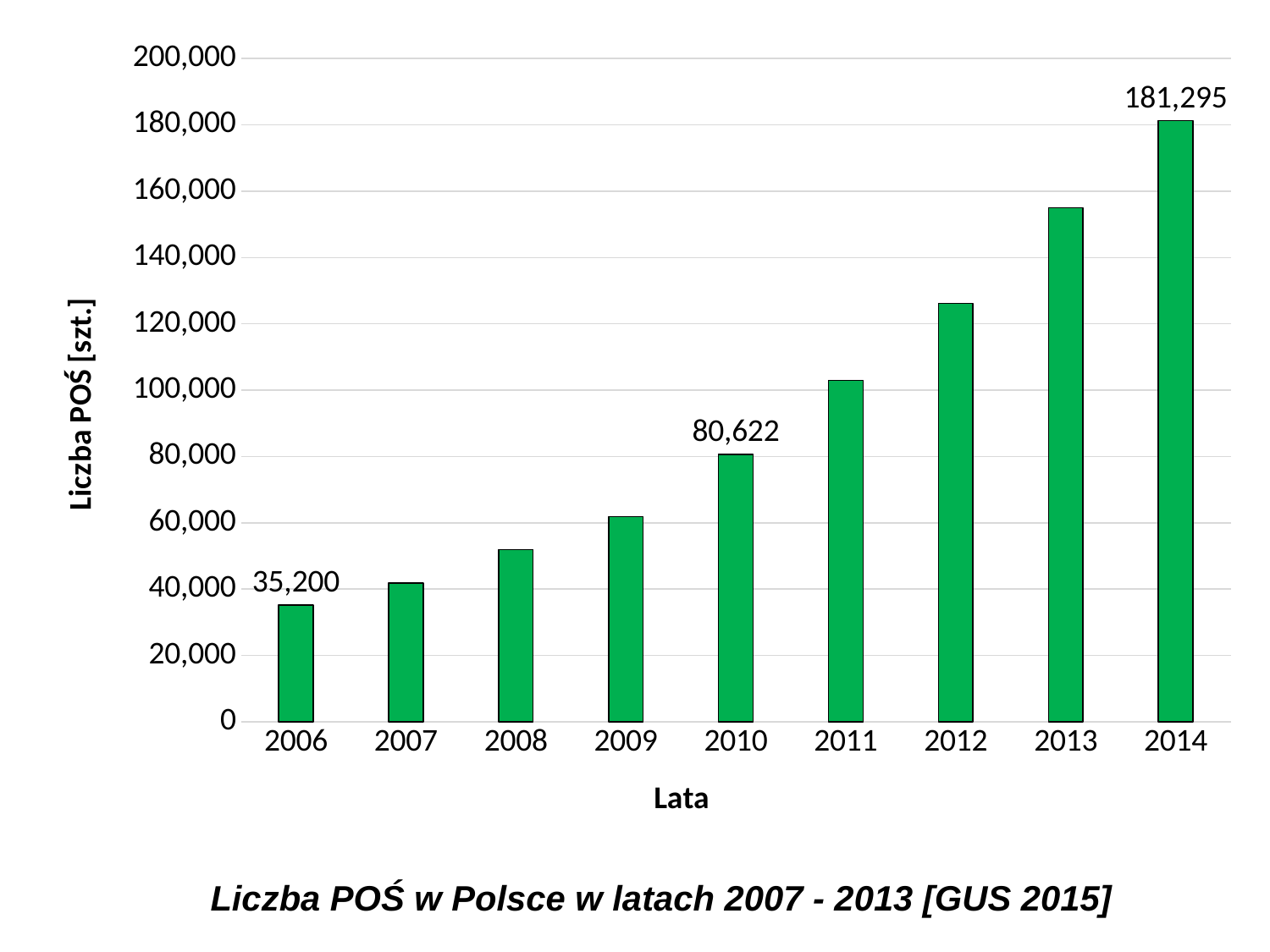
Is the value for 2008 greater or less than 60,000? less Which is larger, the value for 2012 or the value for 2009? 2012 What is the difference between the values for 2014 and 2006? 146,095 Which year has the lowest value? 2006 What is the value for 2014? 181,295 What is the difference between the values for 2010 and 2006? 45,422 Which year has the highest value? 2014 How many years are shown on the x axis? 9 What is the value for 2006? 35,200 What is the value for 2010? 80,622 Do the values rise or fall from 2006 to 2014? rise Is the value for 2013 greater or less than 140,000? greater